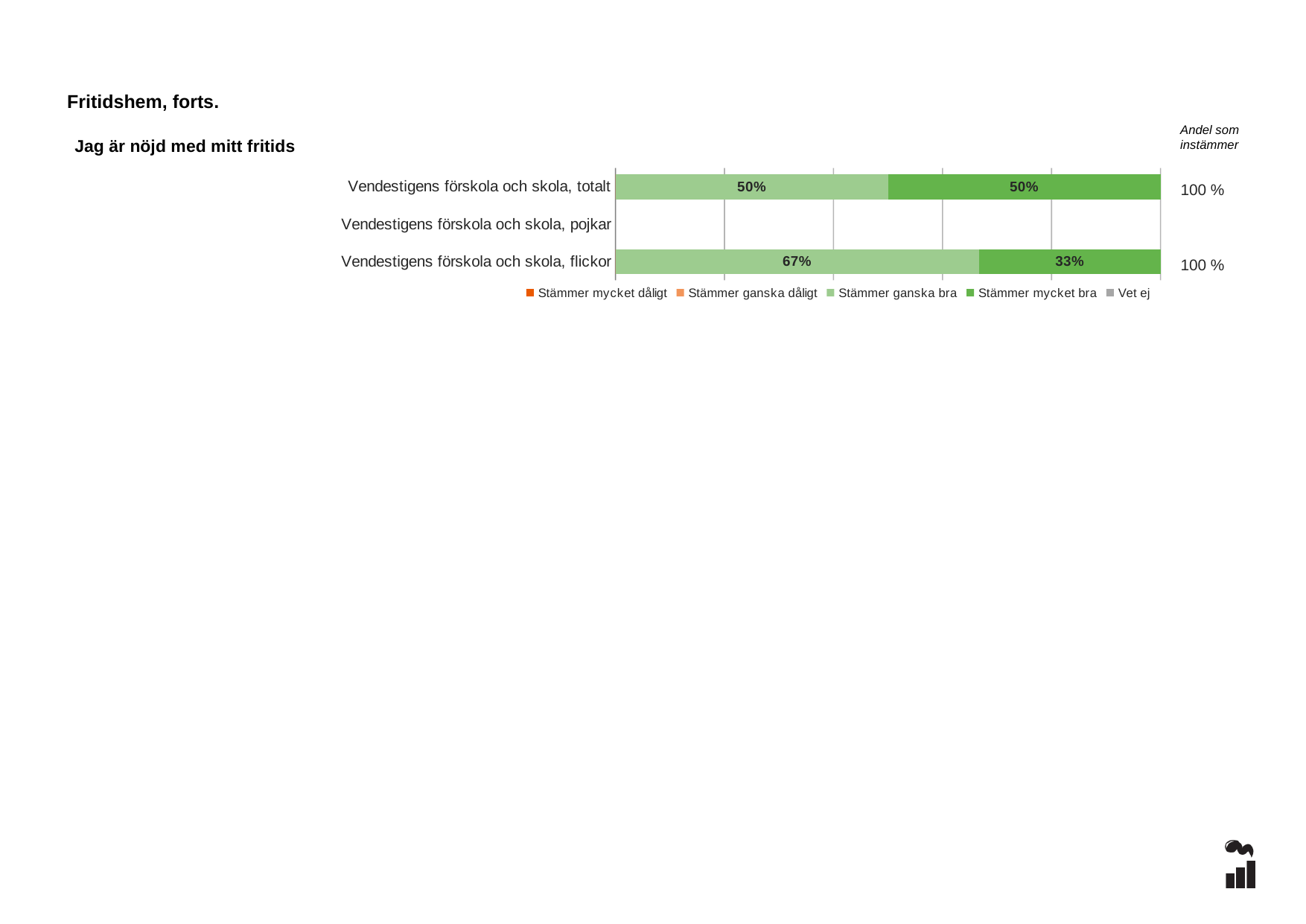
How many categories are shown on the chart? 3 What is the value of 'Stämmer mycket bra' for 'Vendestigens förskola och skola, flickor'? 33% What is the difference between the 'Stämmer ganska bra' and 'Stämmer mycket bra' values for 'Vendestigens förskola och skola, flickor'? 34% What is the 'Andel som instämmer' value shown for 'Vendestigens förskola och skola, totalt'? 100 % What is the value of 'Stämmer mycket bra' for 'Vendestigens förskola och skola, totalt'? 50% What is the title of the chart? Jag är nöjd med mitt fritids What is the total of the stacked bar for 'Vendestigens förskola och skola, flickor'? 100% Which category has the higher 'Stämmer ganska bra' value, 'Vendestigens förskola och skola, totalt' or 'Vendestigens förskola och skola, flickor'? Vendestigens förskola och skola, flickor What is the value of 'Stämmer ganska bra' for 'Vendestigens förskola och skola, flickor'? 67% What kind of chart is shown on the slide? bar chart What is the value of 'Stämmer ganska bra' for 'Vendestigens förskola och skola, totalt'? 50% How many series does the legend list? 5